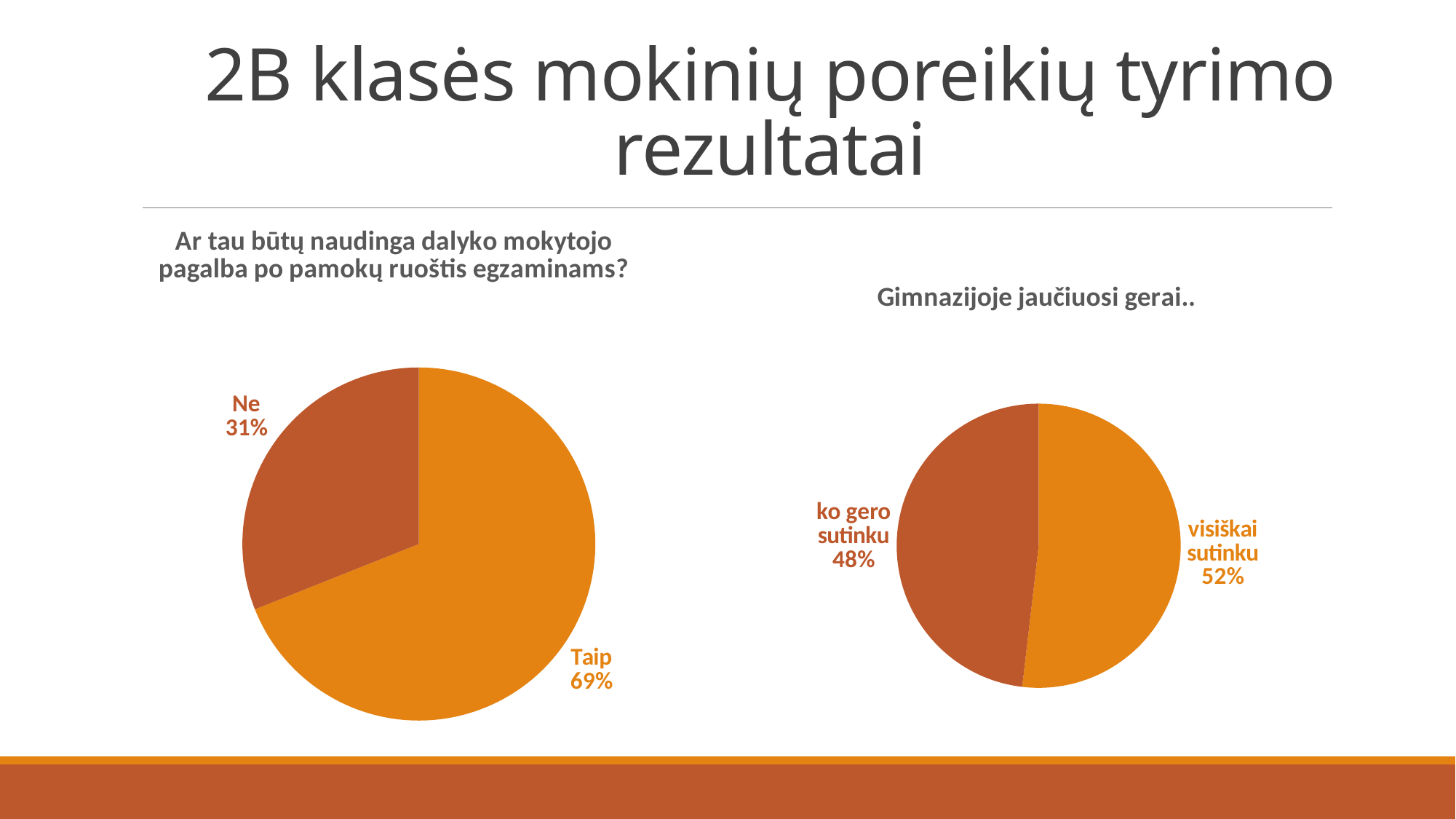
In the right pie chart, what share of the pie is "ko gero sutinku"? 48% In the right pie chart, what is the difference between "visiškai sutinku" and "ko gero sutinku"? 4% Which is larger in the left pie chart: "Ne" or "Taip"? Taip In the left pie chart, what is the value for "Ne"? 31% How many slices does the left pie chart have? 2 In the right pie chart ("Gimnazijoje jaučiuosi gerai.."), what is the value for "visiškai sutinku"? 52% What type of chart is shown on the right side of the slide? Pie chart What is the title of the chart on the right? Gimnazijoje jaučiuosi gerai.. In the left pie chart, which slice is the largest? Taip In the left pie chart ("Ar tau būtų naudinga dalyko mokytojo pagalba po pamokų ruoštis egzaminams?"), what share of the pie is "Taip"? 69% In the left pie chart, what is the difference between the "Taip" and "Ne" shares? 38% In the right pie chart, which slice is the smallest? ko gero sutinku